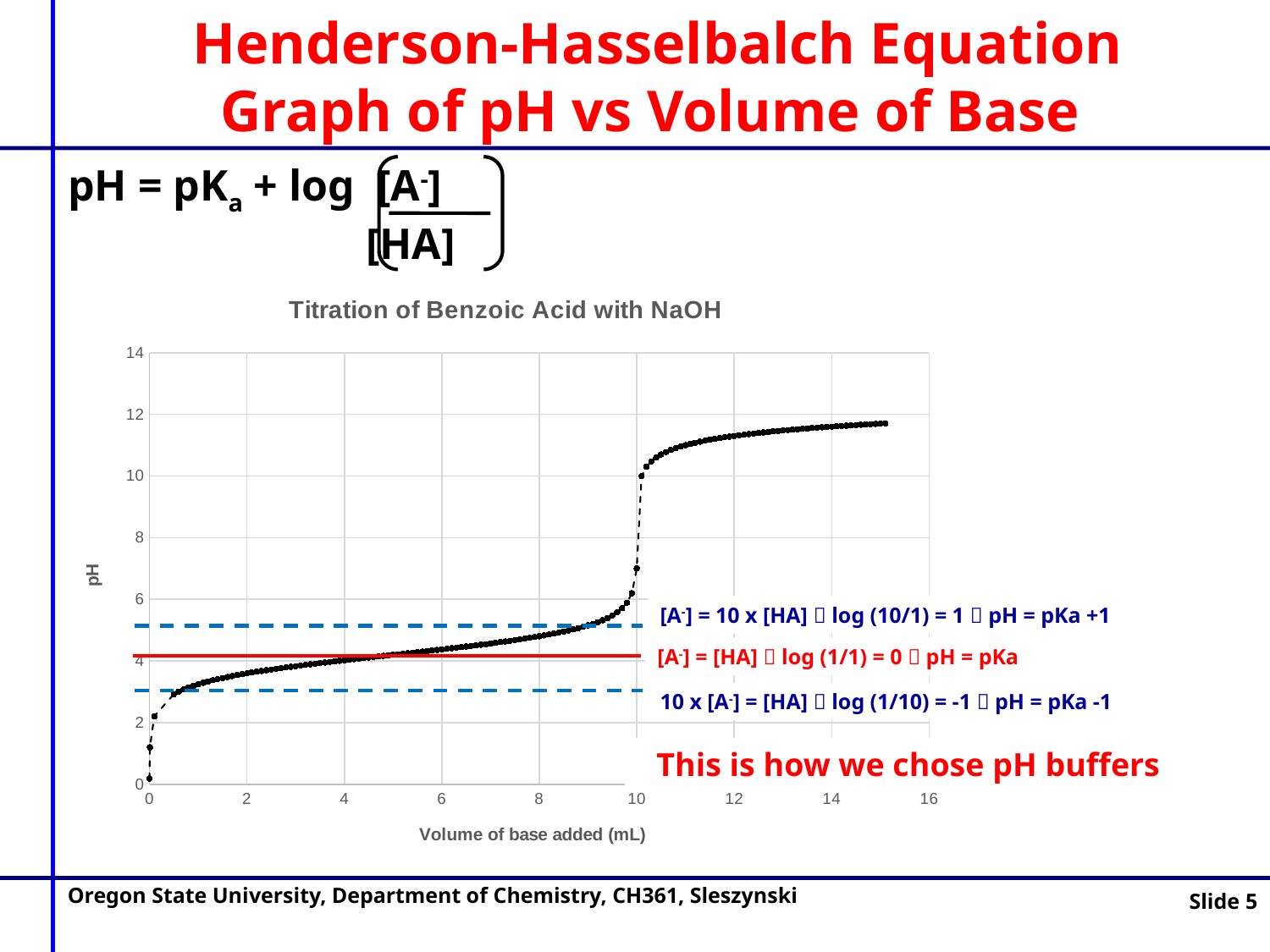
Is the pH at 8 mL of base added greater or less than 4? greater What kind of chart is shown on the slide? scatter (line) chart Does the pH rise or fall as the volume of base added increases? rise Is the pH at 6 mL of base added greater or less than 8? less Is the pH at 8 mL of base added greater or less than 6? less Near which x-axis tick value does the steep jump in pH occur? 10 Is the pH at 14 mL of base added greater or less than the pH at 4 mL? greater What is the title of the chart? Titration of Benzoic Acid with NaOH What is the label of the x axis of the chart? Volume of base added (mL)